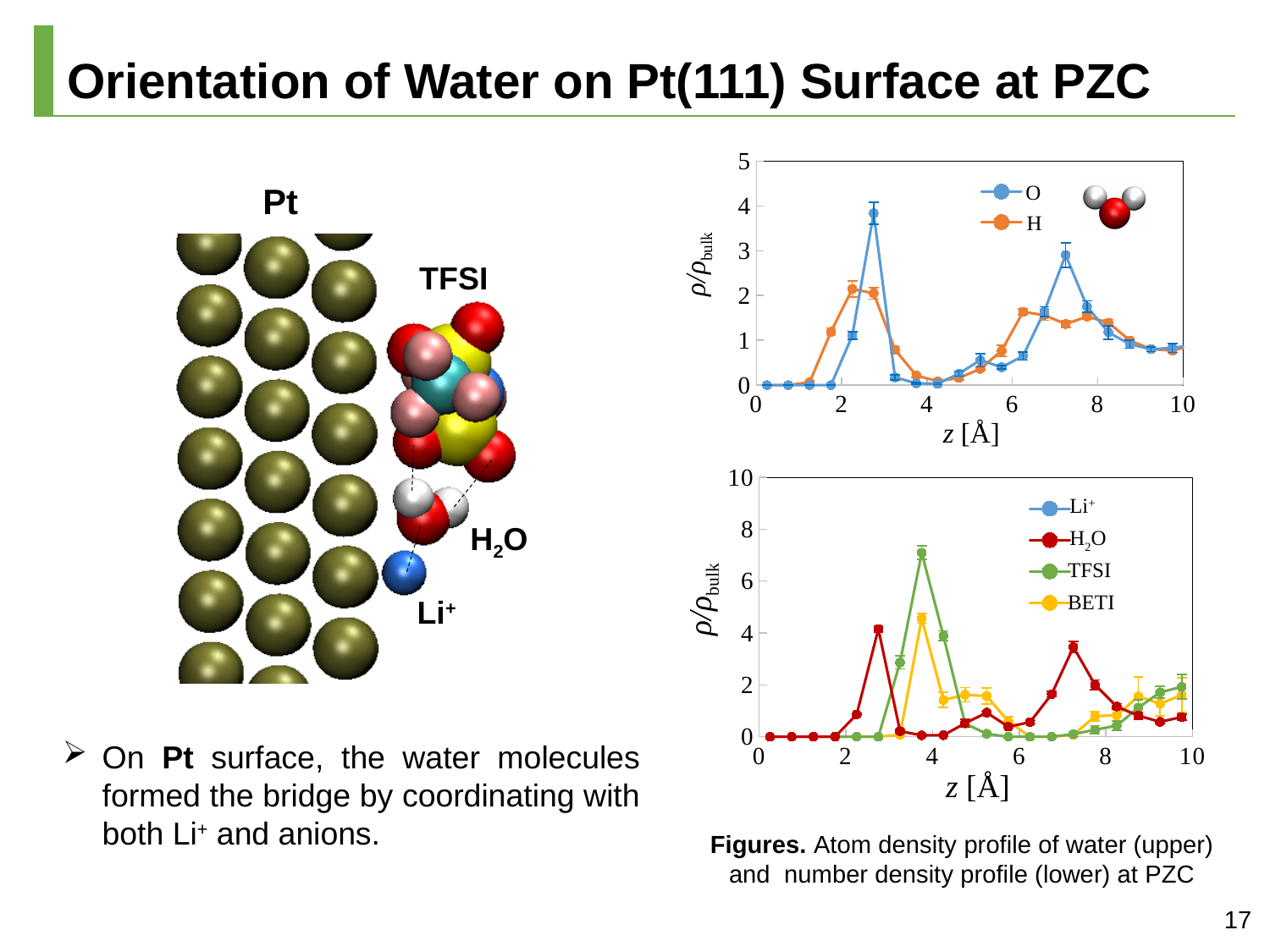
In the upper chart, is the peak value of the H series greater or less than 3? less What is the x-axis label of the upper chart? z [Å] What are the legend entries of the lower chart? Li+, H2O, TFSI, BETI In the lower chart, which series reaches the highest peak? TFSI How many series does the legend of the upper chart list? 2 In the lower chart, is the peak value of the H2O series greater or less than 6? less How many series does the legend of the lower chart list? 4 In the upper chart, is the peak value of the O series greater or less than 3? greater In the upper chart, which series reaches the higher peak, O or H? O What kind of chart is the upper chart? line chart